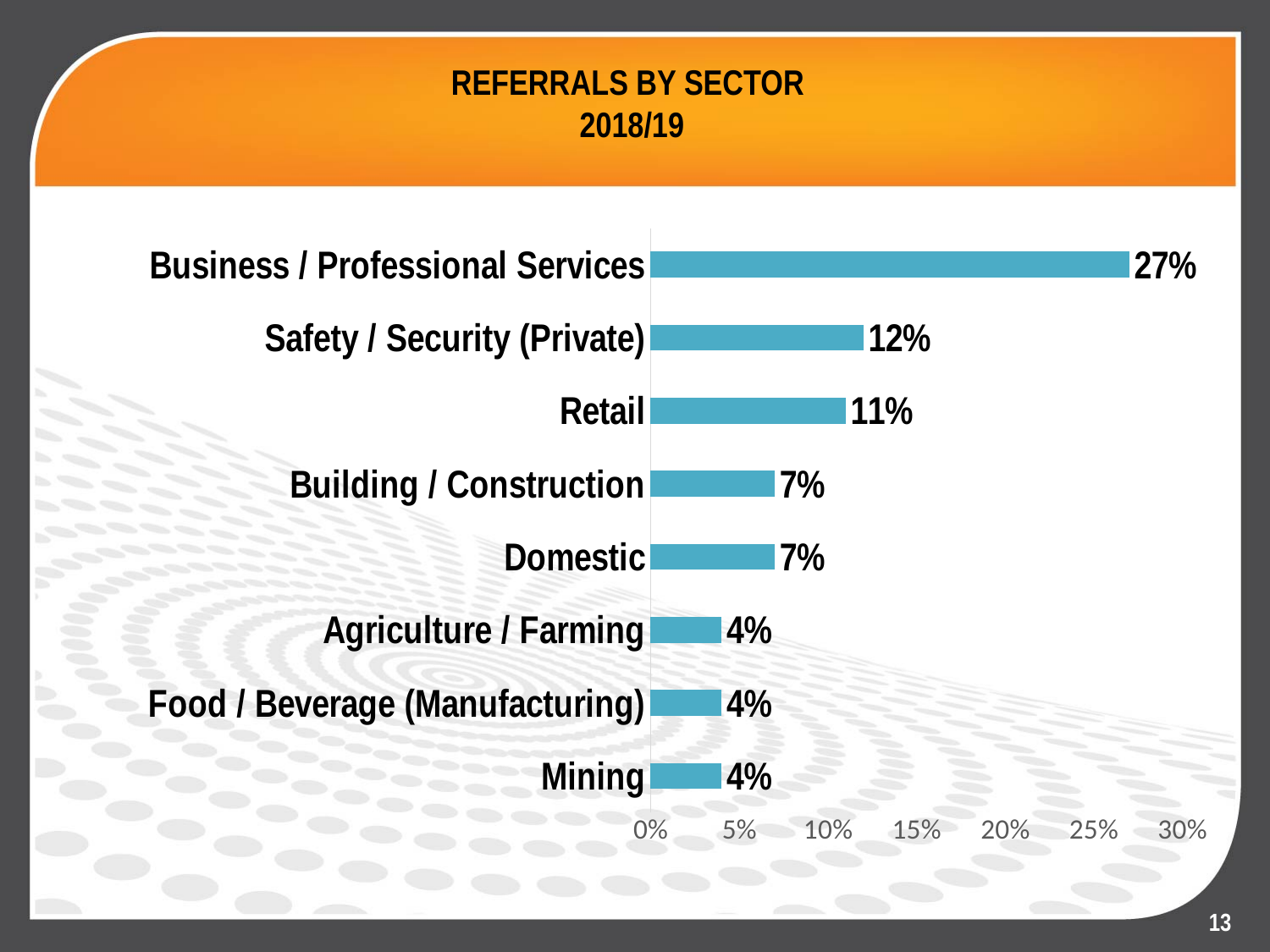
What percentage of referrals came from the Business / Professional Services sector? 27% What is the title of the chart? REFERRALS BY SECTOR 2018/19 How many sectors have a value of 4%? 3 What is the difference between the values for Retail and Building / Construction? 4% Is the value for Business / Professional Services greater or less than 25%? greater Which sector has the highest share of referrals? Business / Professional Services What percentage is shown for Safety / Security (Private)? 12% How many sectors are shown in the chart? 8 What is the difference between the values for Business / Professional Services and Safety / Security (Private)? 15% What kind of chart is shown on the slide? Bar chart Which is larger, the value for Safety / Security (Private) or the value for Retail? Safety / Security (Private) What is the value shown for Retail? 11%